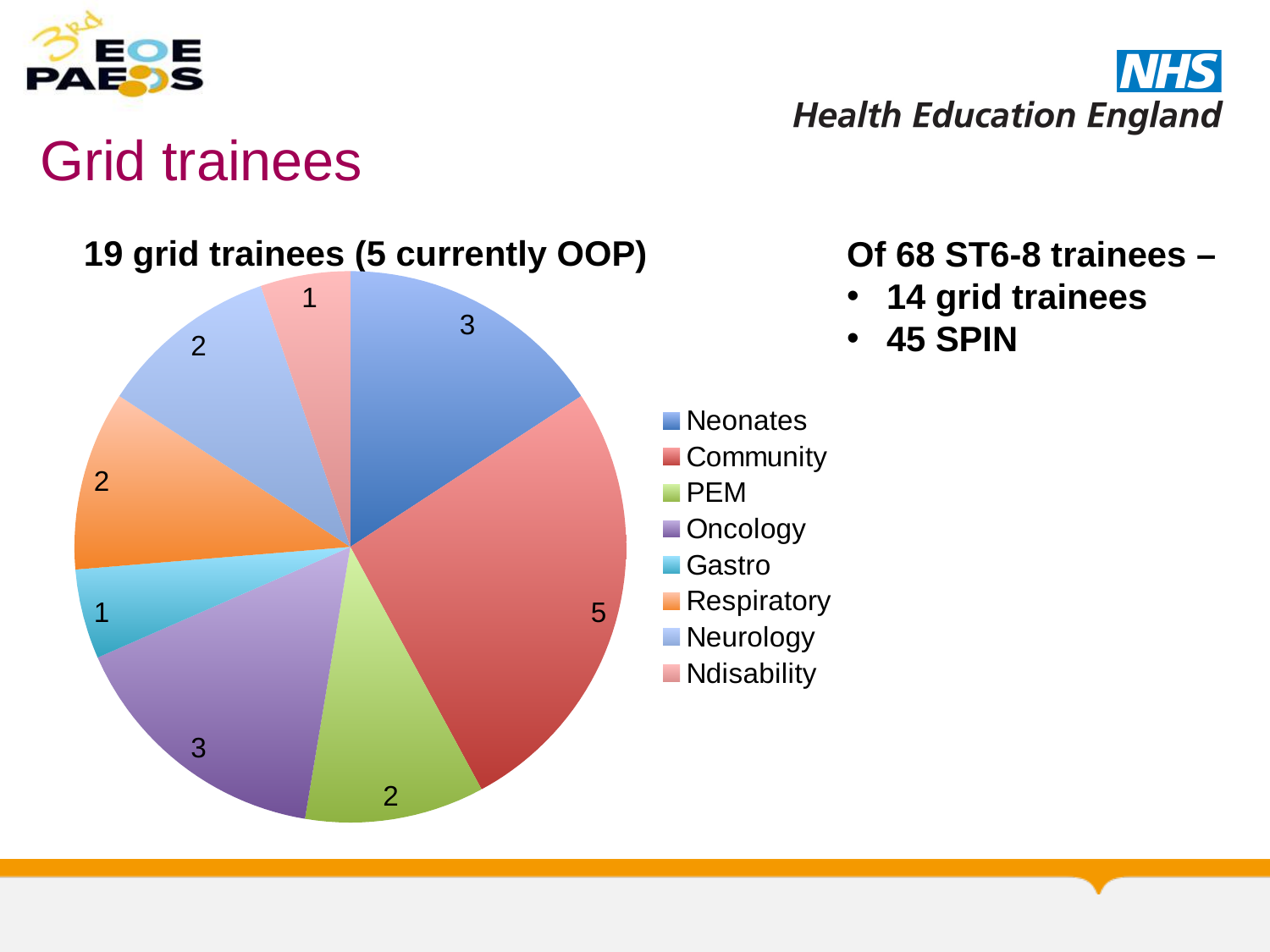
What is the value for Respiratory in the pie chart? 2 What is the value for Community in the pie chart? 5 Which category has the largest slice of the pie chart? Community How many categories does the pie chart show? 8 Which legend entry is shown in red in the pie chart? Community What kind of chart is shown on the slide? Pie chart What is the total of all the slices in the pie chart? 19 What is the value for Gastro in the pie chart? 1 What is the value for Neonates in the pie chart? 3 Which is larger, the value for Neonates or the value for PEM? Neonates What is the title of the pie chart? 19 grid trainees (5 currently OOP) What is the difference between the Community value and the Oncology value? 2